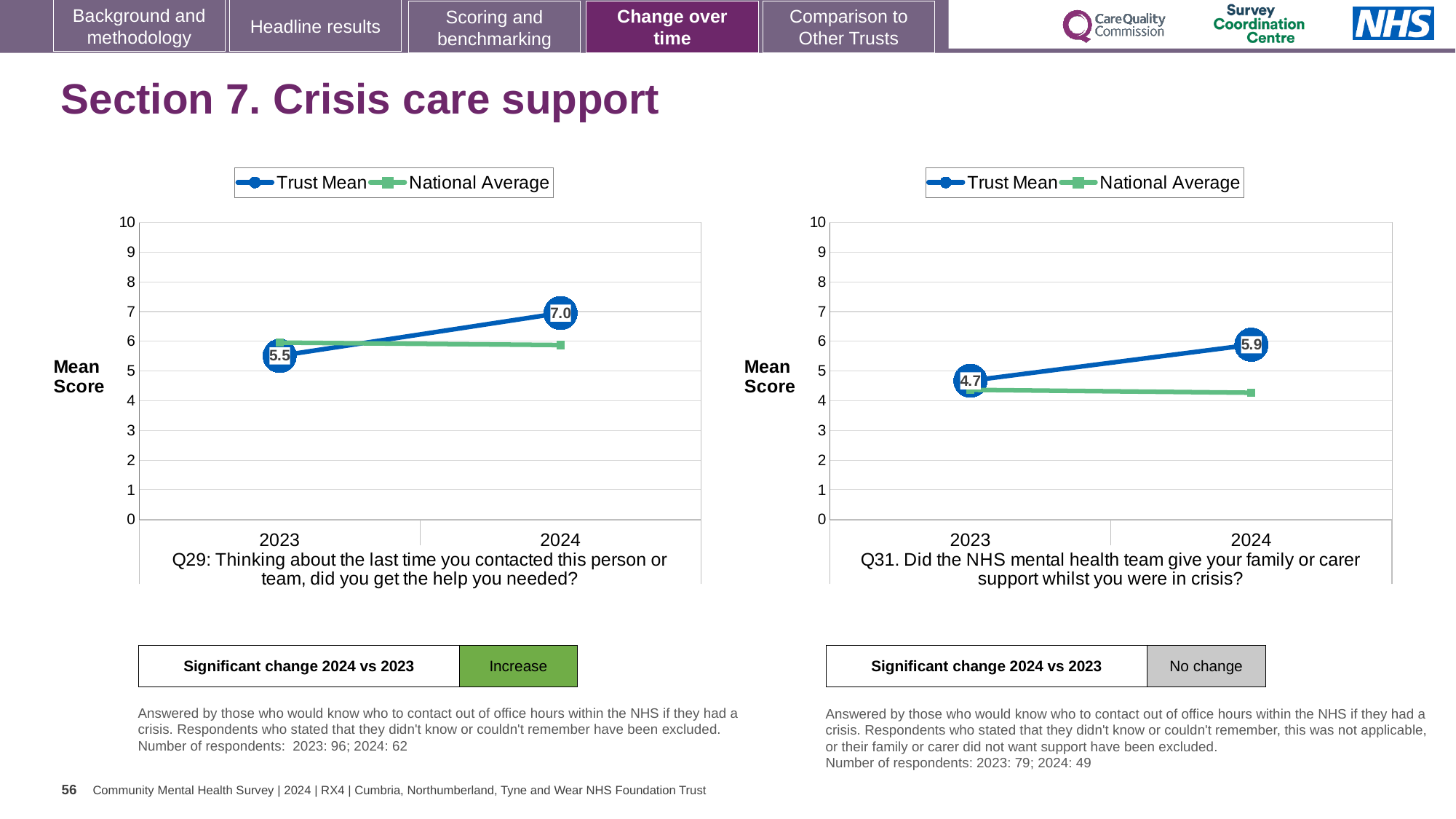
In the Q31 chart on the right, what is the difference between the Trust Mean for 2024 and 2023? 1.2 In the Q29 chart on the left, by how much did the Trust Mean change from 2023 to 2024? 1.5 In the Q31 chart on the right, which is larger in 2024, the Trust Mean or the National Average? Trust Mean In the Q31 chart on the right, what is the Trust Mean score for 2024? 5.9 In the Q29 chart on the left, what is the Trust Mean score for 2023? 5.5 In the Q31 chart on the right, what is the Trust Mean score for 2023? 4.7 In the Q29 chart on the left, does the Trust Mean rise or fall from 2023 to 2024? rise In the Q29 chart on the left, what is the Trust Mean score for 2024? 7.0 What type of chart is the Q31 chart on the right? line chart How many series does the legend of the Q29 chart on the left list? 2 In the Q31 chart on the right, is the National Average for 2024 greater or less than 5? less In the Q29 chart on the left, is the National Average for 2023 greater or less than 5? greater